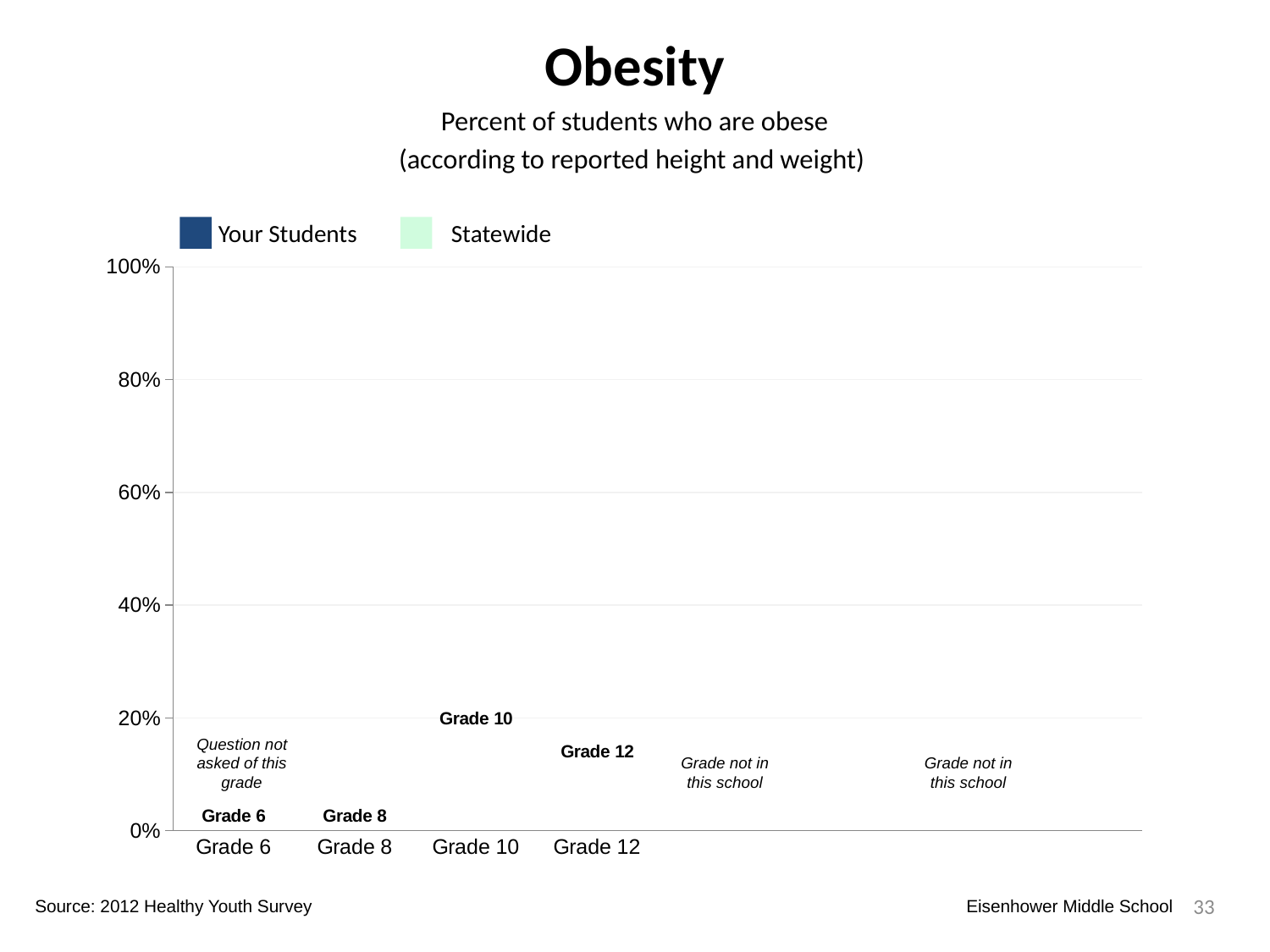
What are the two series named in the legend? Your Students and Statewide What is the highest value shown on the y axis? 100% How many grade categories are labeled on the x axis? 4 How many series does the legend list? 2 What is the title of the chart? Obesity What note is shown for Grade 6 in the chart? Question not asked of this grade